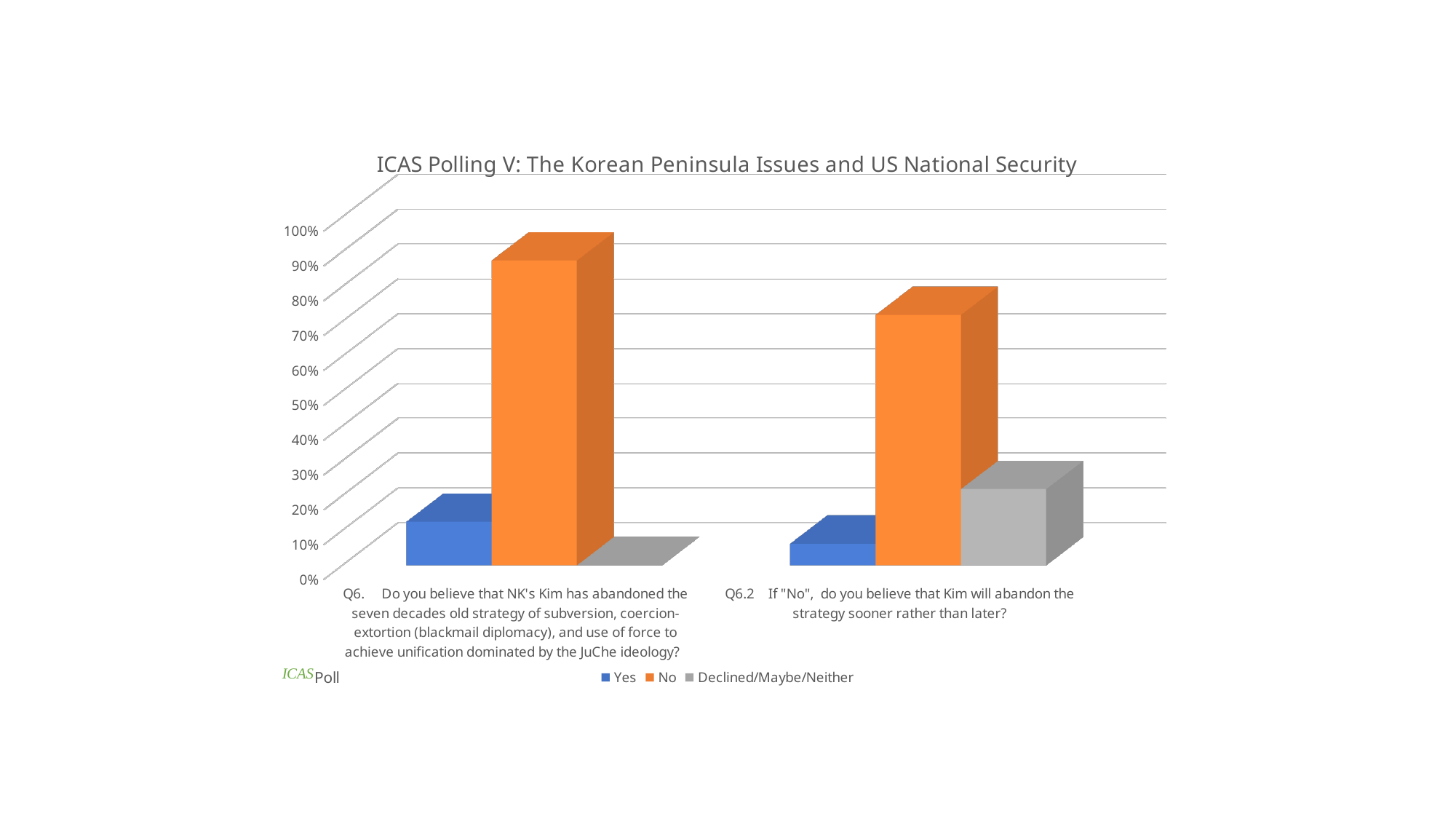
How many series does the legend list? 3 Which response has the highest value for Q6? No What kind of chart is shown on the slide? bar chart Is the value for "Yes" on Q6.2 greater or less than 20%? less Which response has the lowest value for Q6.2? Yes What is the title of the chart? ICAS Polling V: The Korean Peninsula Issues and US National Security Is the value for "No" on Q6.2 greater or less than 50%? greater Is the value for "No" on Q6 greater or less than 70%? greater How many question categories are plotted along the x axis? 2 Which response has the lowest value for Q6? Declined/Maybe/Neither Which is larger: the "No" value for Q6 or the "No" value for Q6.2? Q6